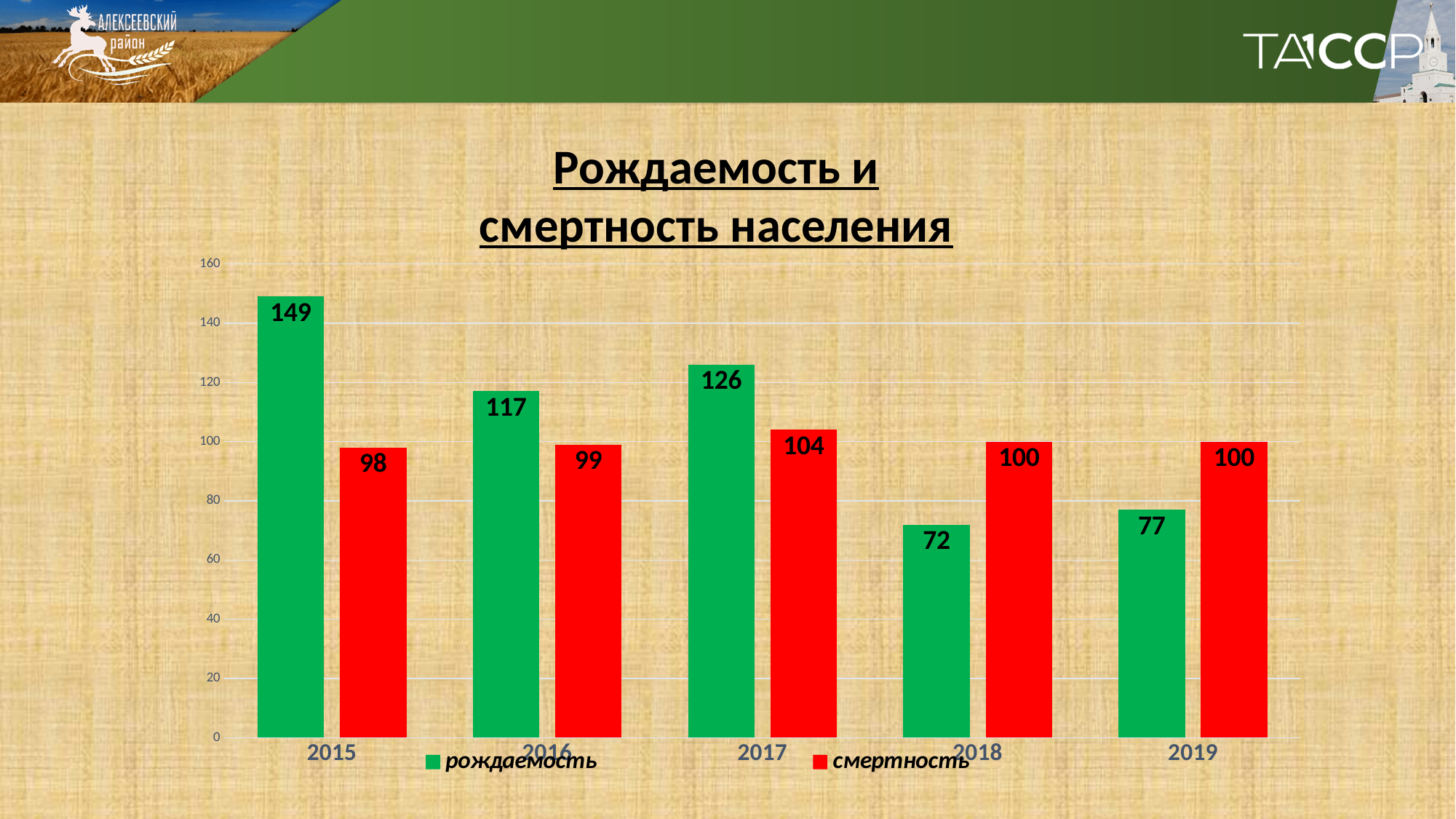
What colour are the смертность bars? red What is the рождаемость value for 2018? 72 What is the difference between рождаемость and смертность in 2015? 51 Which year has the lowest рождаемость value? 2018 Which year has the lowest смертность value? 2015 What is the смертность value for 2017? 104 What is the рождаемость value for 2015? 149 Which year has the highest рождаемость value? 2015 How many years are shown on the x axis? 5 What kind of chart is shown on the slide? bar chart Which is larger in 2019, рождаемость or смертность? смертность How many series does the legend list? 2